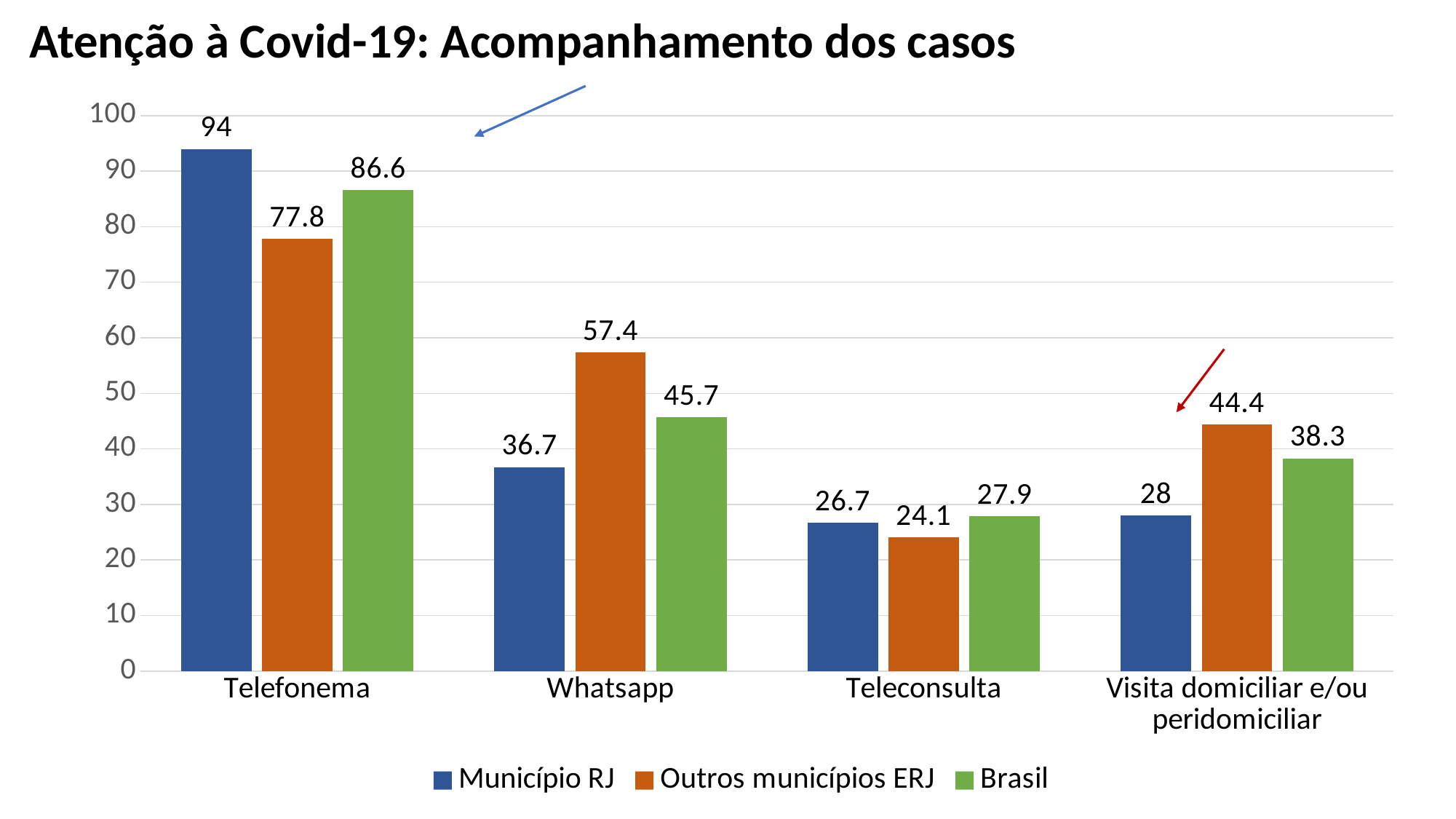
What is the value for Município RJ in the Telefonema category? 94 What is the difference between Município RJ and Outros municípios ERJ in the Whatsapp category? 20.7 Which colour represents the Brasil series? Green How many series does the legend list? 3 Which is larger in the Teleconsulta category: Município RJ or Outros municípios ERJ? Município RJ What is the value for Brasil in the Whatsapp category? 45.7 Which category has the highest value for Outros municípios ERJ? Telefonema How many categories are shown on the x axis? 4 What is the value for Outros municípios ERJ in the Visita domiciliar e/ou peridomiciliar category? 44.4 Is the value for Brasil in the Visita domiciliar e/ou peridomiciliar category greater or less than 40? less What kind of chart is shown on the slide? Bar chart Which category has the lowest value for Brasil? Teleconsulta